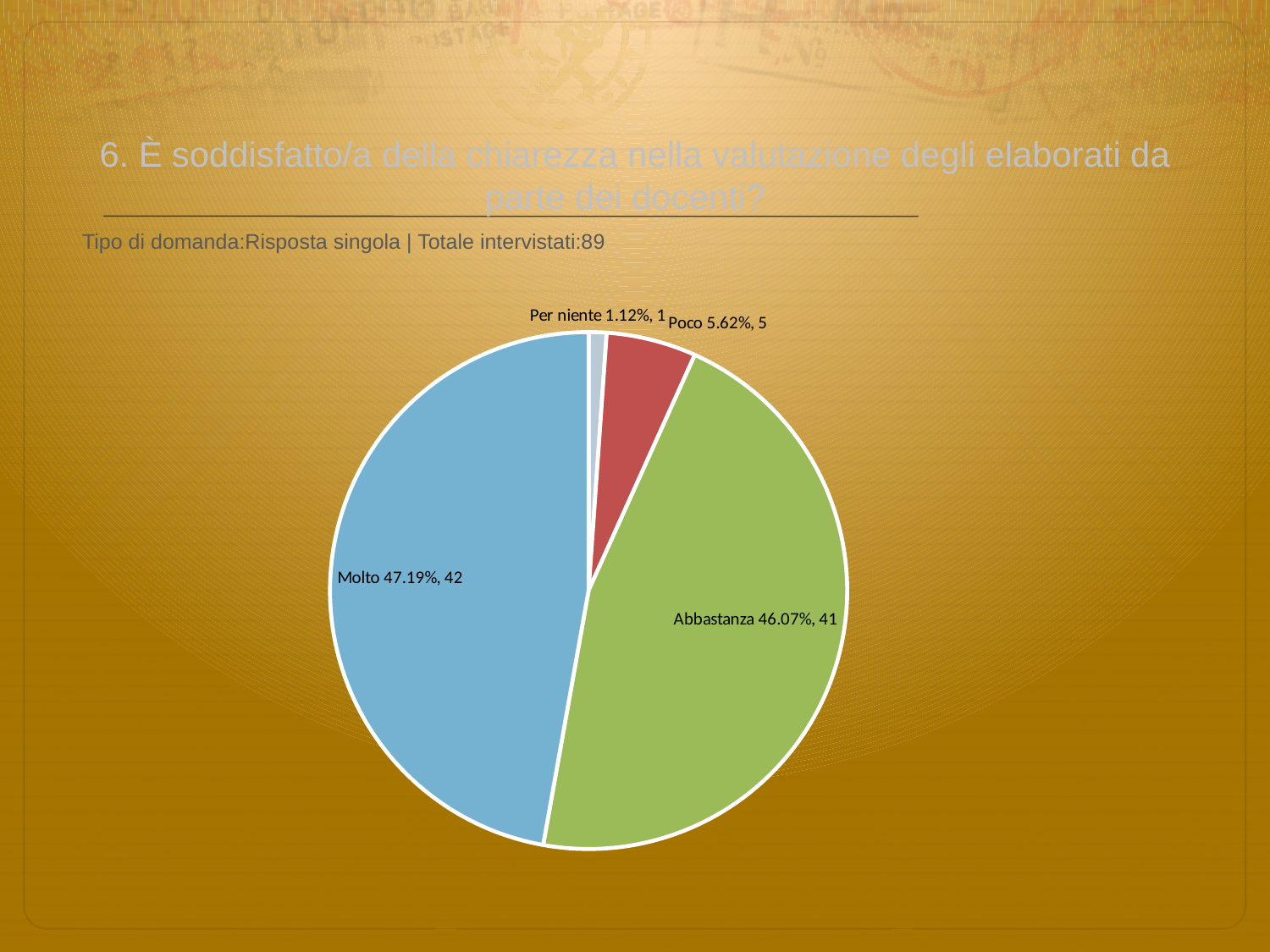
Which response category has the smallest share of the pie? Per niente What is the share of the pie for "Abbastanza"? 46.07% What is the difference in number of respondents between "Molto" and "Abbastanza"? 1 How many slices does the pie chart have? 4 What kind of chart is shown on the slide? pie chart Which has more respondents, "Poco" or "Per niente"? Poco How many respondents answered "Per niente"? 1 What percentage of respondents answered "Molto"? 47.19% What percentage of respondents answered "Poco"? 5.62% Which response category has the largest share of the pie? Molto What colour is the "Molto" slice of the pie chart? blue How many respondents answered "Abbastanza"? 41